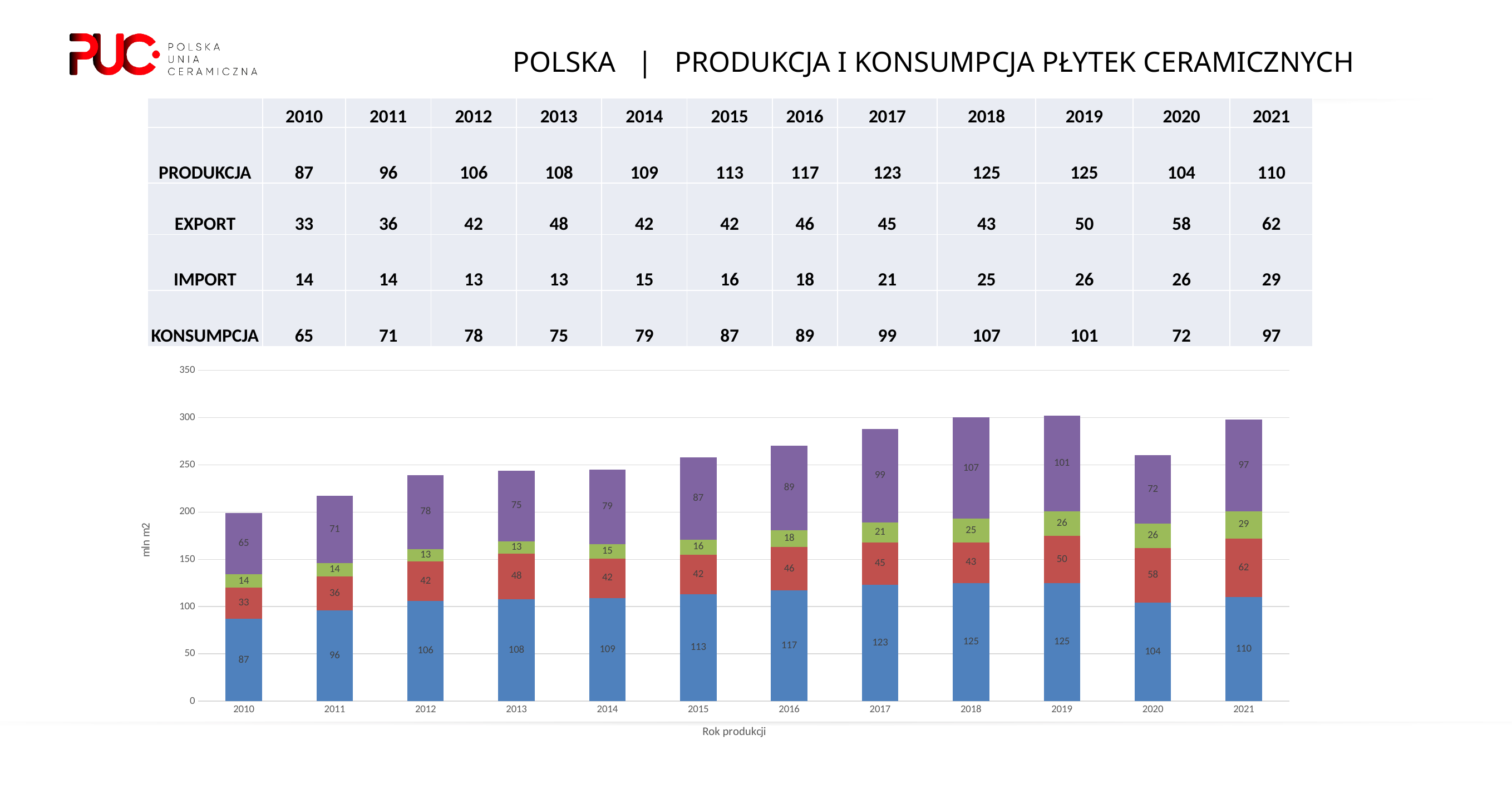
Is the total height of the stacked bar for 2016 greater or less than 250? greater Which year has the larger KONSUMPCJA value, 2019 or 2020? 2019 What is the total of the stacked bar for 2010? 199 What kind of chart is shown on the slide? Stacked bar chart What is the KONSUMPCJA value for 2018 in the chart? 107 What is the difference between the EXPORT value in 2021 and in 2010? 29 What is the PRODUKCJA value for 2015 in the stacked bar chart? 113 Which year has the lowest PRODUKCJA value? 2010 What is the IMPORT value for 2021 in the chart? 29 Which year has the highest KONSUMPCJA value? 2018 How many years are shown on the x axis of the chart? 12 What is the label on the y axis of the chart? mln m2